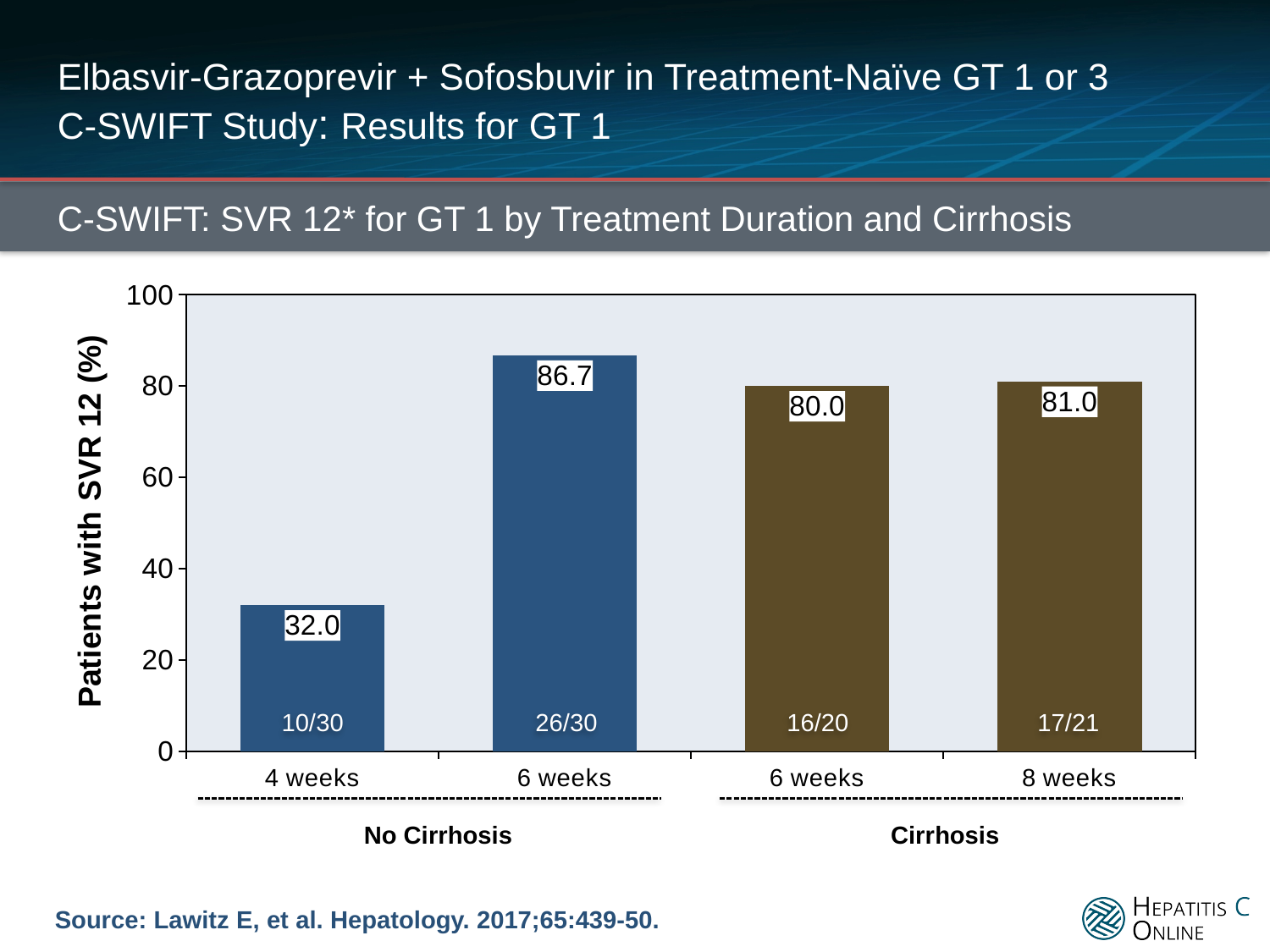
What type of chart is shown on the slide? Bar chart What is the difference in SVR 12 rate between the 6 weeks and 4 weeks groups with no cirrhosis? 54.7 What fraction of patients is shown inside the bar for 6 weeks with no cirrhosis? 26/30 What is the SVR 12 rate for the 6 weeks group with cirrhosis? 80.0 Which has a higher SVR 12 rate: 6 weeks with no cirrhosis or 6 weeks with cirrhosis? 6 weeks with no cirrhosis What is the SVR 12 rate for the 4 weeks group with no cirrhosis? 32.0 Which group has the lowest SVR 12 rate? 4 weeks, No Cirrhosis What is the label of the y-axis? Patients with SVR 12 (%) How many bars are shown in the chart? 4 Which group has the highest SVR 12 rate? 6 weeks, No Cirrhosis What is the SVR 12 rate for the 8 weeks group with cirrhosis? 81.0 Is the SVR 12 rate for the 4 weeks no cirrhosis group greater or less than 40? less